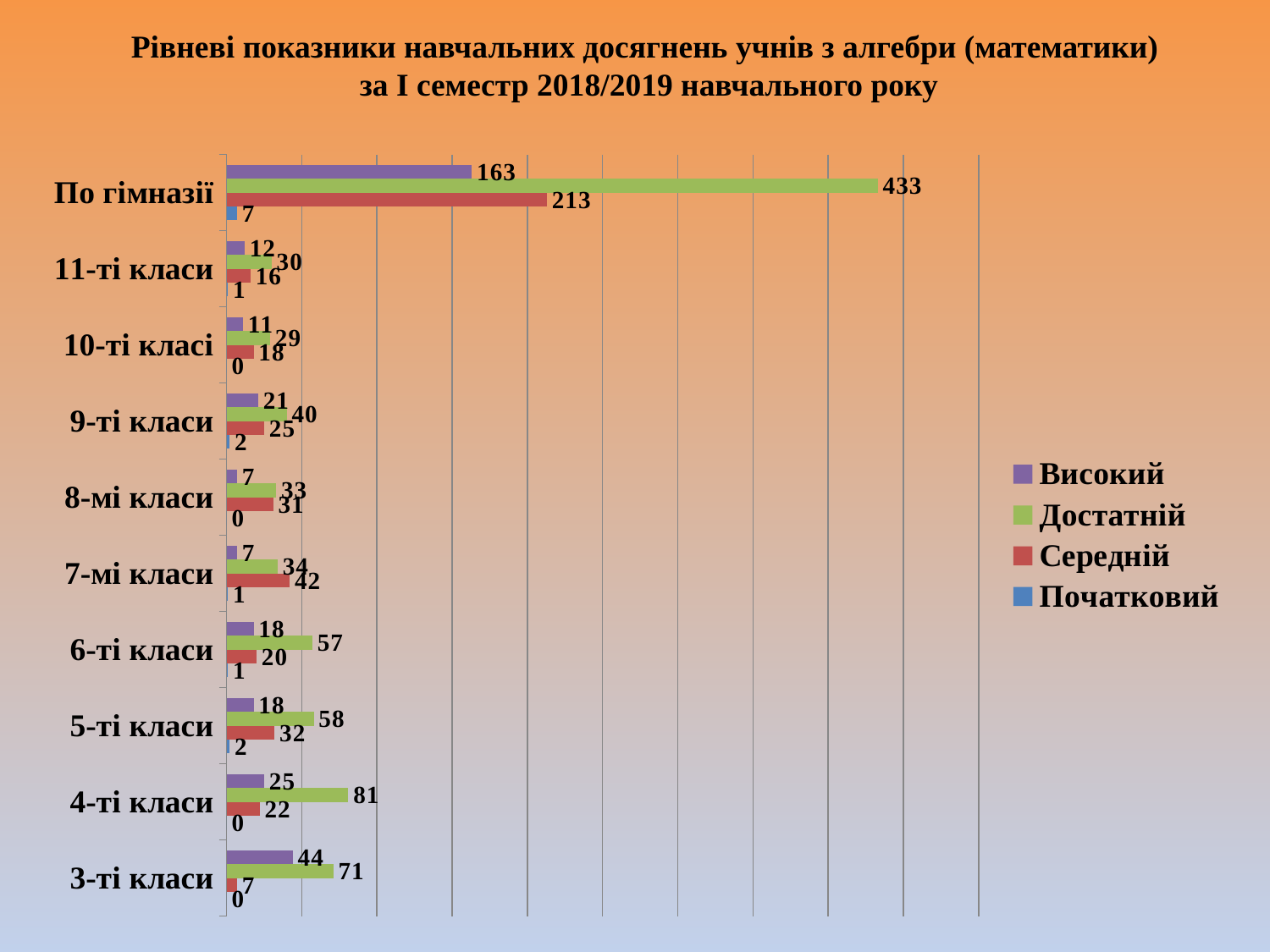
What is the value of Високий for 3-ті класи? 44 Which series is shown in green in the legend? Достатній Excluding По гімназії, which class has the highest Достатній value? 4-ті класи What is the difference between the Достатній and Середній values for По гімназії? 220 Excluding По гімназії, which class has the lowest Середній value? 3-ті класи Which is larger for 7-мі класи: Достатній or Середній? Середній What type of chart is shown on the slide? bar chart How many series does the legend list? 4 What is the value of Достатній for По гімназії? 433 What is the value of Середній for 7-мі класи? 42 How many categories are shown on the vertical axis? 10 What is the value of Початковий for 9-ті класи? 2